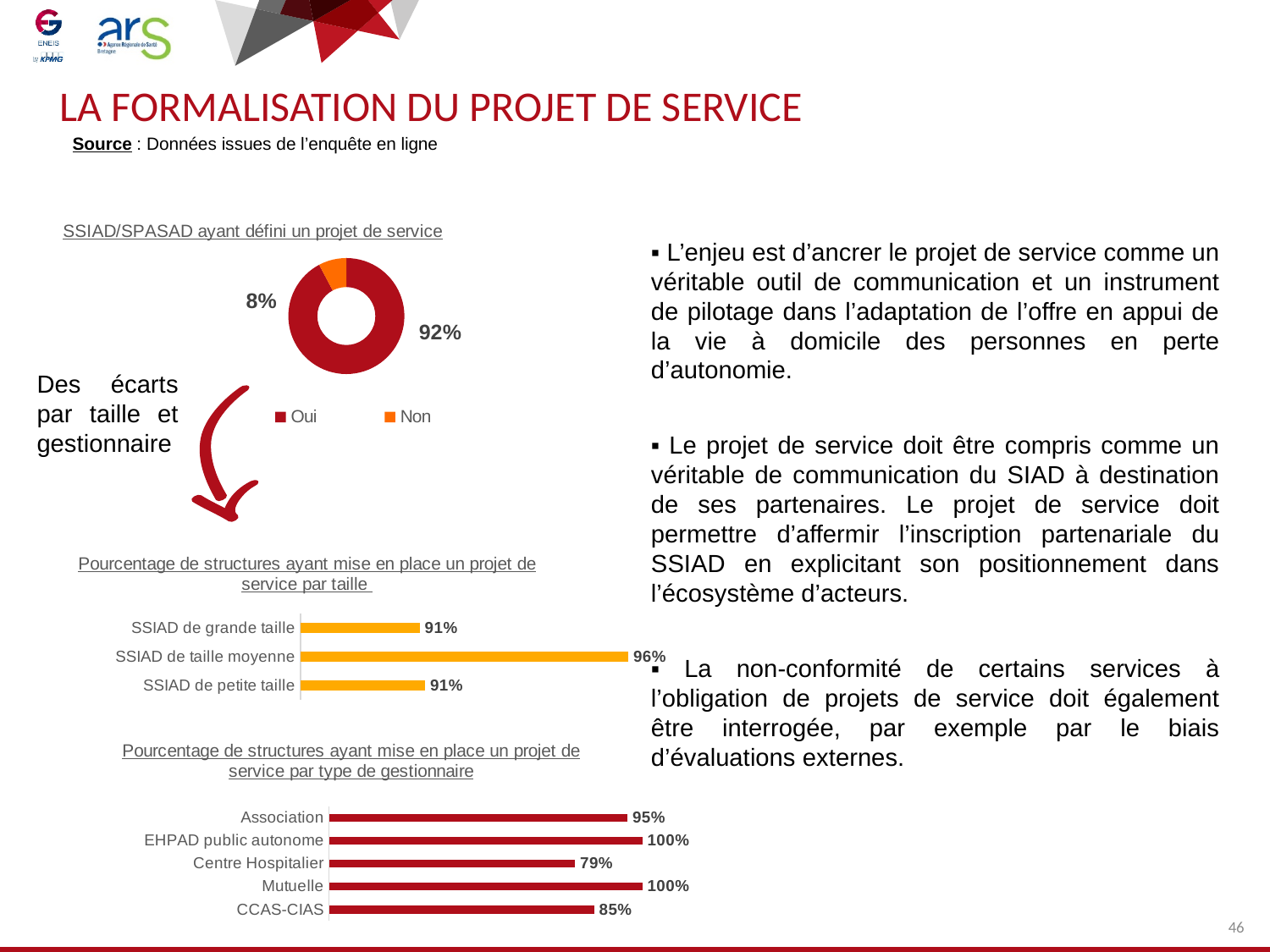
In the chart 'Pourcentage de structures ayant mise en place un projet de service par type de gestionnaire', which category has the lowest value? Centre Hospitalier In the chart 'SSIAD/SPASAD ayant défini un projet de service', what share is 'Oui'? 92% How many categories are shown in the chart 'Pourcentage de structures ayant mise en place un projet de service par taille'? 3 In the chart 'Pourcentage de structures ayant mise en place un projet de service par taille', what is the value for 'SSIAD de taille moyenne'? 96% In the chart 'Pourcentage de structures ayant mise en place un projet de service par type de gestionnaire', which is larger: 'Association' or 'CCAS-CIAS'? Association In the chart 'Pourcentage de structures ayant mise en place un projet de service par type de gestionnaire', what is the value for 'Centre Hospitalier'? 79% What kind of chart is 'SSIAD/SPASAD ayant défini un projet de service'? Donut (pie) chart How many categories are shown in the chart 'Pourcentage de structures ayant mise en place un projet de service par type de gestionnaire'? 5 In the chart 'Pourcentage de structures ayant mise en place un projet de service par type de gestionnaire', what is the difference between 'EHPAD public autonome' and 'CCAS-CIAS'? 15% In the chart 'Pourcentage de structures ayant mise en place un projet de service par taille', which category has the highest value? SSIAD de taille moyenne In the chart 'SSIAD/SPASAD ayant défini un projet de service', what share is 'Non'? 8% In the chart 'Pourcentage de structures ayant mise en place un projet de service par taille', what is the difference between 'SSIAD de taille moyenne' and 'SSIAD de petite taille'? 5%